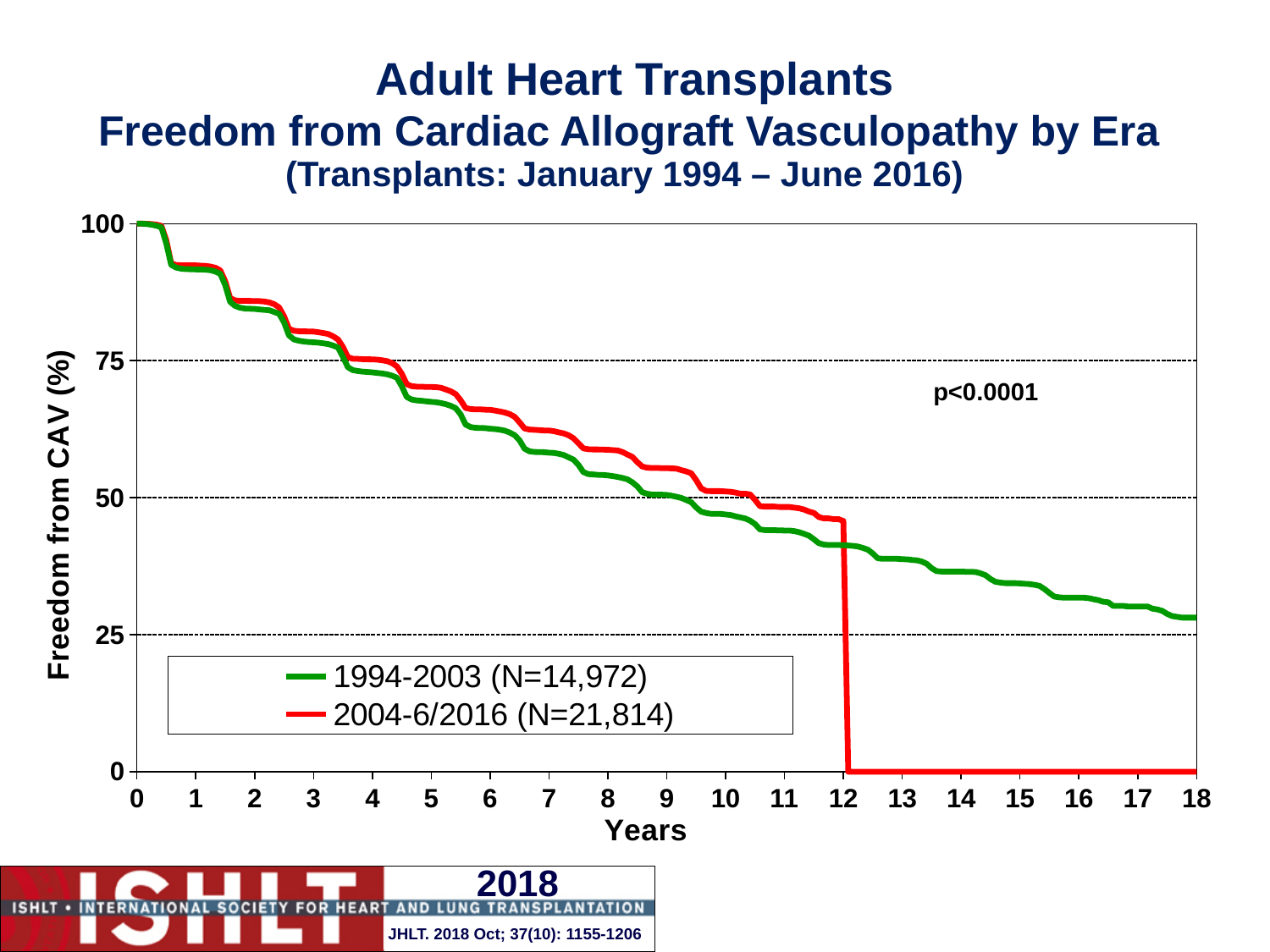
Is the freedom from CAV for the 1994-2003 era at 18 years greater or less than 25? greater What p-value is printed on the chart? p<0.0001 What kind of chart is shown on the slide? line chart What sample size (N) is given in the legend for the 1994-2003 era? 14,972 Is the freedom from CAV for the 2004-6/2016 era at 2 years greater or less than 75? greater What sample size (N) is given in the legend for the 2004-6/2016 era? 21,814 Is the freedom from CAV for the 1994-2003 era at 18 years greater or less than 50? less What is the label of the y axis? Freedom from CAV (%) How many series does the legend list? 2 What is the highest value shown on the x axis (Years)? 18 Do the freedom from CAV curves rise or fall as years increase? fall At 8 years, which era has the higher freedom from CAV, 1994-2003 or 2004-6/2016? 2004-6/2016